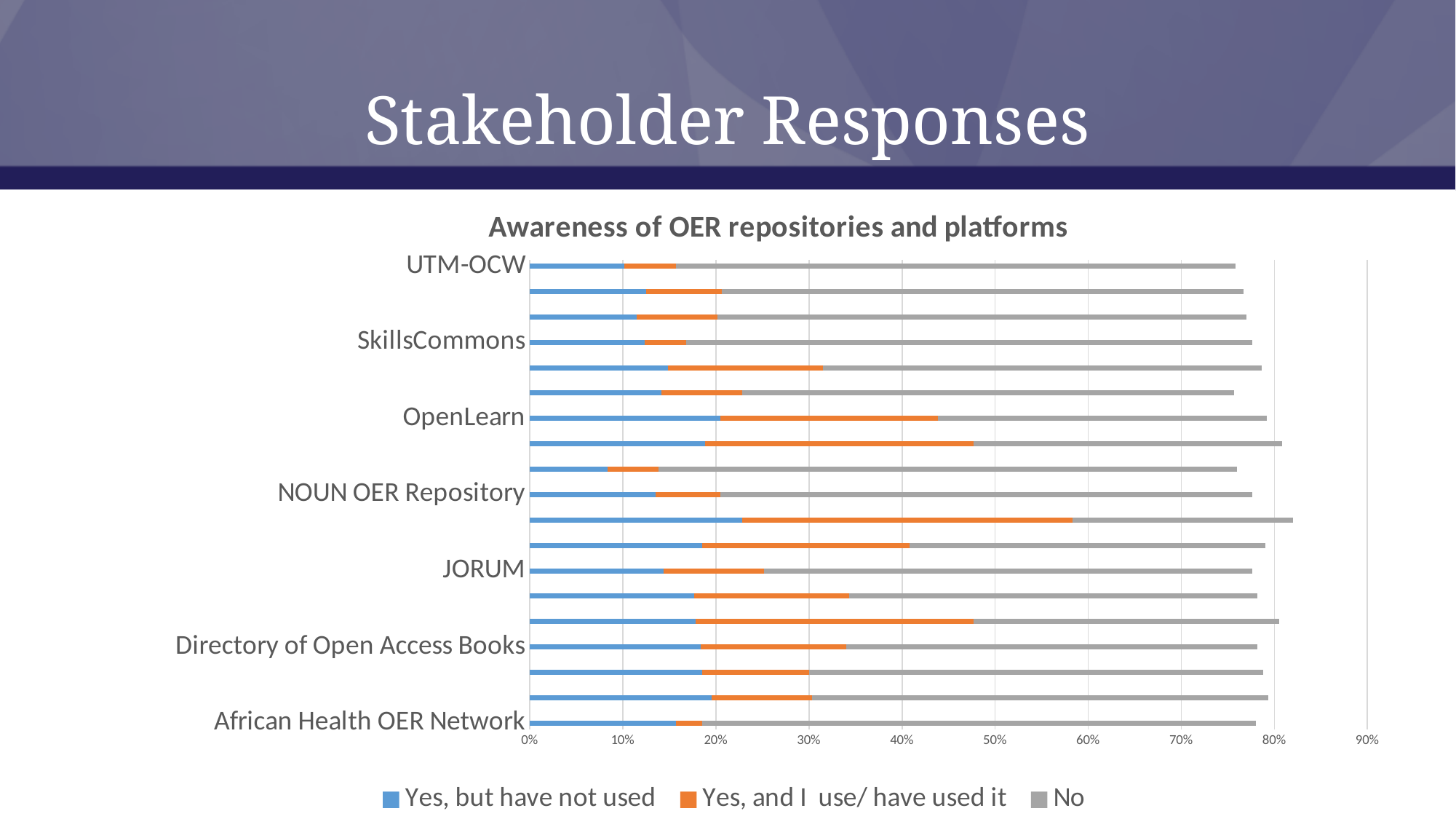
Which has the larger 'Yes, but have not used' value, African Health OER Network or UTM-OCW? African Health OER Network What kind of chart is shown on the slide? Stacked bar chart Which has the larger 'Yes, and I use/ have used it' segment, OpenLearn or UTM-OCW? OpenLearn Is the total length of the UTM-OCW bar greater or less than 80%? less Is the 'Yes, but have not used' value for SkillsCommons greater or less than 10%? greater Is the 'Yes, but have not used' value for African Health OER Network greater or less than 20%? less Which series is shown in orange in the legend? Yes, and I use/ have used it How many series does the legend list? 3 What is the title of the chart? Awareness of OER repositories and platforms